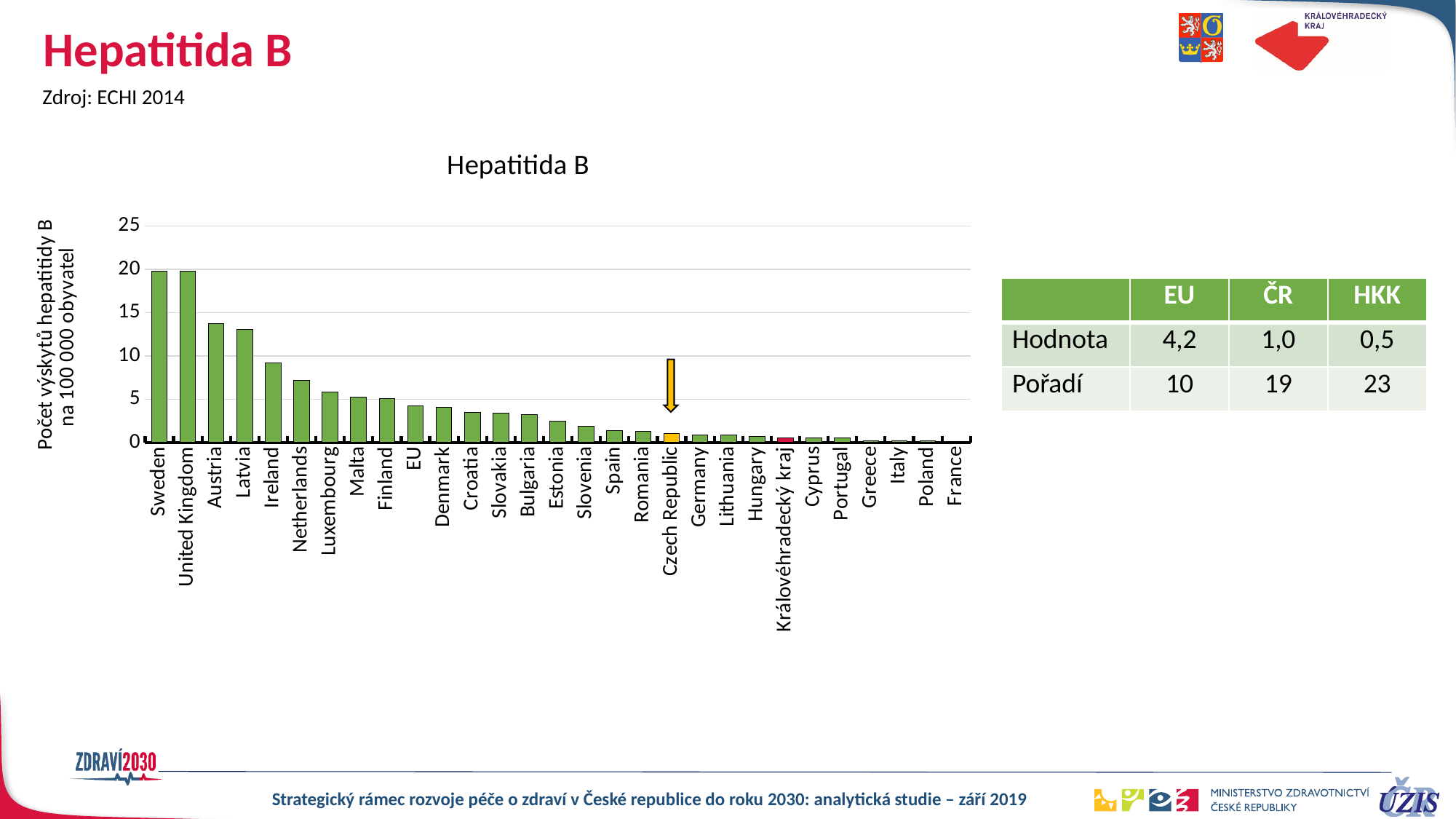
Which has a larger value, Austria or Ireland? Austria Is the value for Ireland greater or less than 10? less Is the value for Sweden greater or less than 15? greater What is the title of the chart? Hepatitida B What is the value for Královéhradecký kraj in the chart? 0,5 Do the values rise or fall from left to right along the x axis? fall Is the value for Netherlands greater or less than 5? greater What is the value for Czech Republic in the chart? 1,0 What kind of chart is shown on the slide? bar chart How many categories are plotted along the x axis of the chart? 29 What is the value for EU in the chart? 4,2 What is the difference between the value for EU and the value for Czech Republic? 3,2